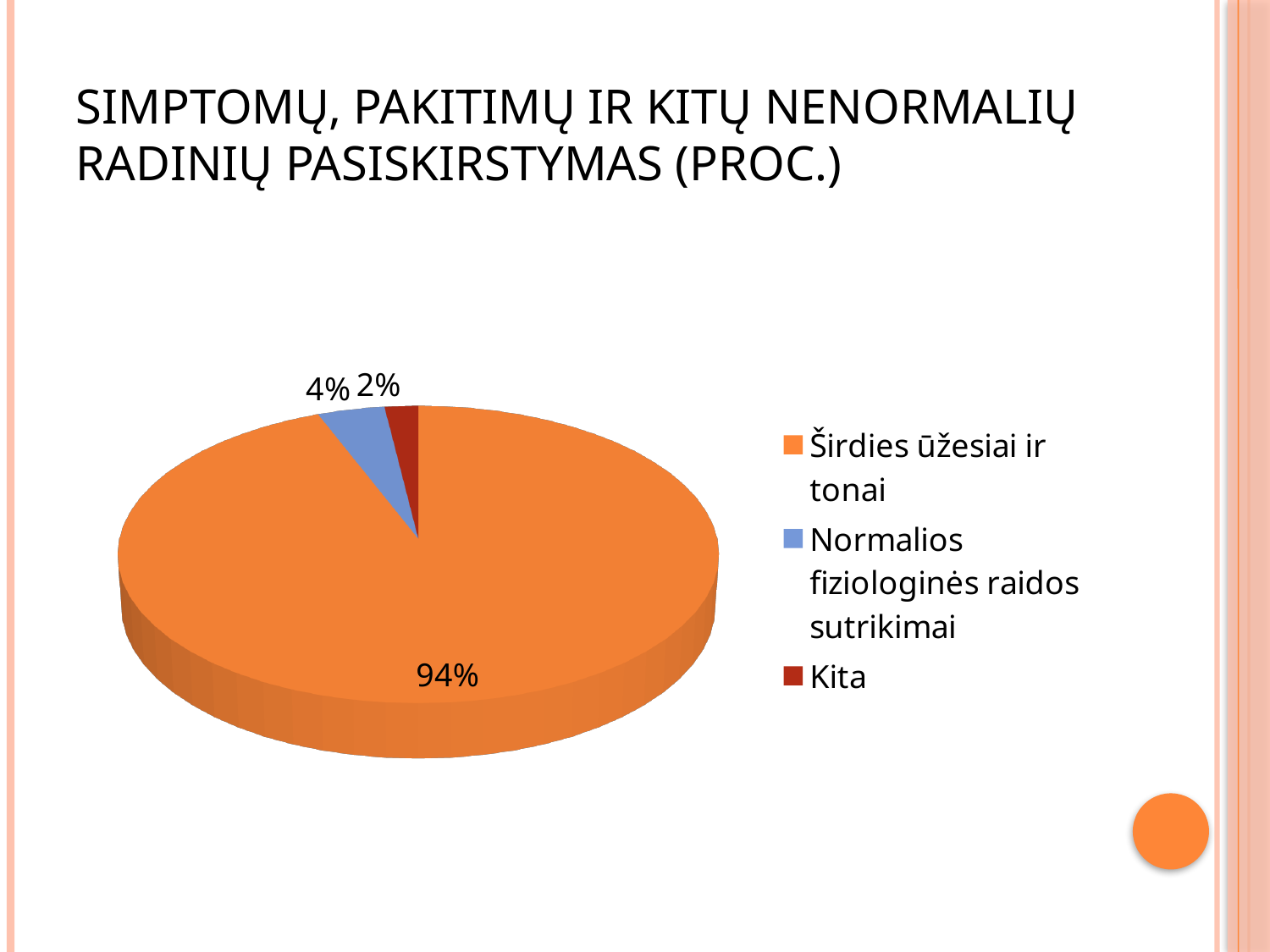
What share of the pie does "Kita" have? 2% What kind of chart is shown on the slide? Pie chart What share of the pie does "Širdies ūžesiai ir tonai" have? 94% How many categories does the pie chart have? 3 What share of the pie does "Normalios fiziologinės raidos sutrikimai" have? 4% What is the title of the slide containing the chart? Simptomų, pakitimų ir kitų nenormalių radinių pasiskirstymas (proc.) Which category has the smallest slice of the pie? Kita What colour is the slice for "Kita"? Dark red What is the difference between the shares of "Širdies ūžesiai ir tonai" and "Normalios fiziologinės raidos sutrikimai"? 90% What is the difference between the shares of "Normalios fiziologinės raidos sutrikimai" and "Kita"? 2% Which is larger: the share of "Normalios fiziologinės raidos sutrikimai" or the share of "Kita"? Normalios fiziologinės raidos sutrikimai Which category has the largest slice of the pie? Širdies ūžesiai ir tonai